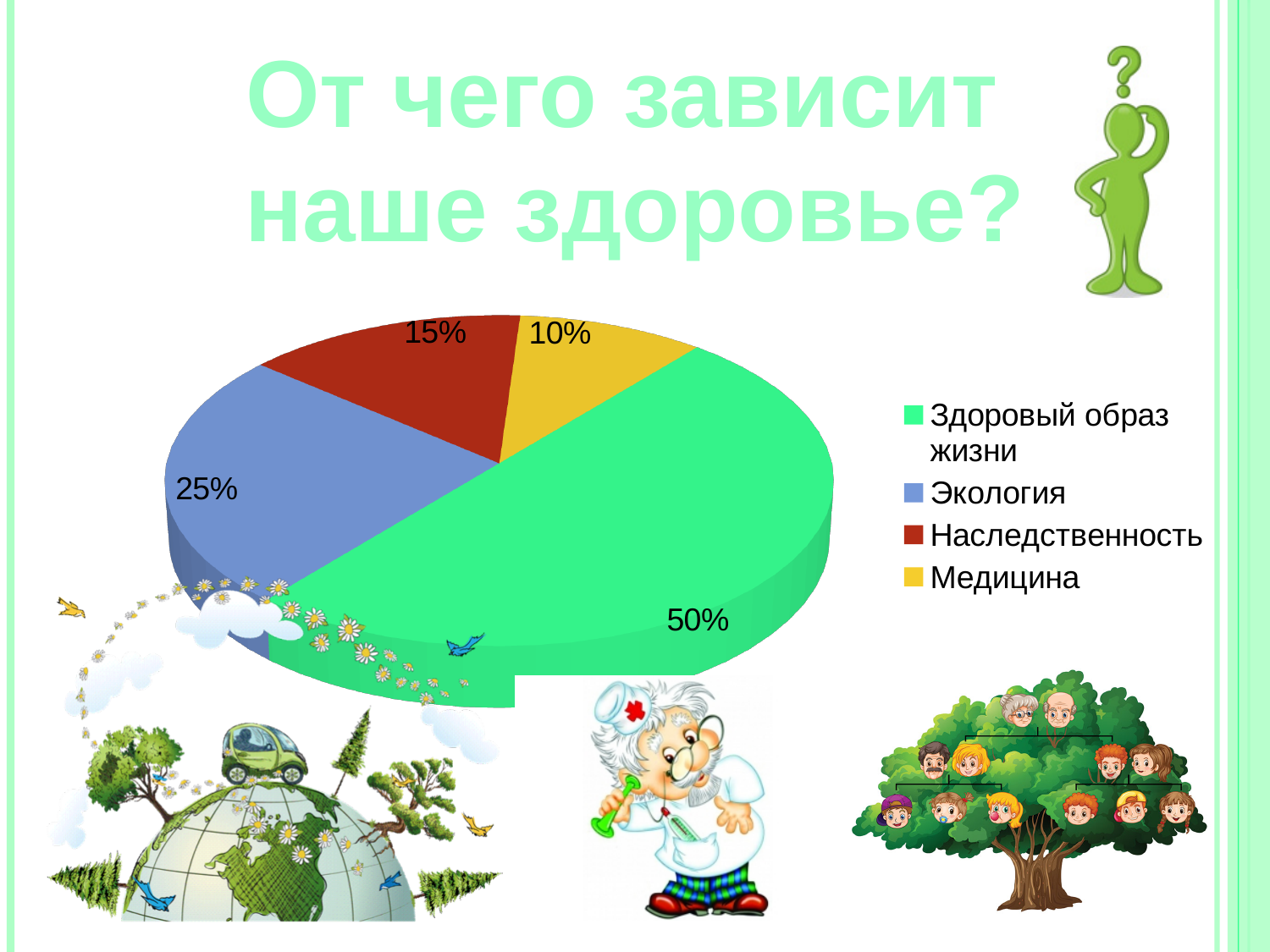
What colour is the slice for Экология? blue Which is larger, the share for Наследственность or the share for Медицина? Наследственность Which category has the largest slice of the pie? Здоровый образ жизни How many slices does the pie chart have? 4 How many entries does the legend list? 4 What share of the pie does Медицина have? 10% What kind of chart is shown on the slide? pie chart What is the difference between the shares of Здоровый образ жизни and Экология? 25% What share of the pie does Экология have? 25% Which category has the smallest slice of the pie? Медицина What share of the pie does Наследственность have? 15% What share of the pie does Здоровый образ жизни have? 50%